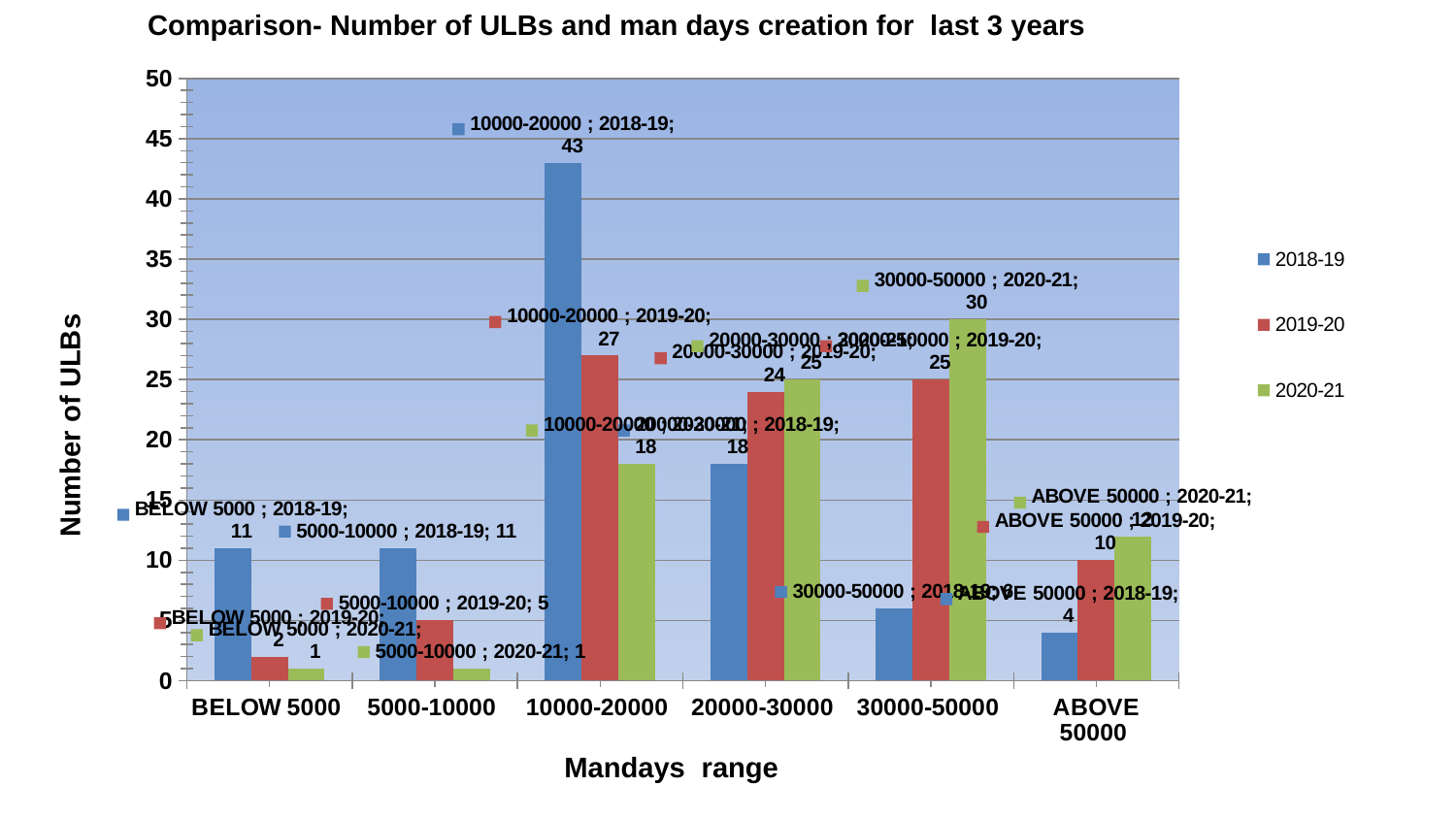
Which mandays range has the lowest value in the 2020-21 series? BELOW 5000 and 5000-10000 (both 1) Which mandays range has the highest value in the 2018-19 series? 10000-20000 What kind of chart is shown on the slide? bar chart How many series does the legend list? 3 What is the value for 30000-50000 in the 2020-21 series? 30 What is the difference between the 2018-19 and 2019-20 values for 10000-20000? 16 What is the value for 20000-30000 in the 2019-20 series? 24 For 30000-50000, which is larger: the 2019-20 value or the 2020-21 value? 2020-21 What is the value for 10000-20000 in the 2018-19 series? 43 What is the value for BELOW 5000 in the 2018-19 series? 11 Is the value for 30000-50000 in the 2018-19 series greater or less than 10? less How many mandays range categories are shown on the x axis? 6